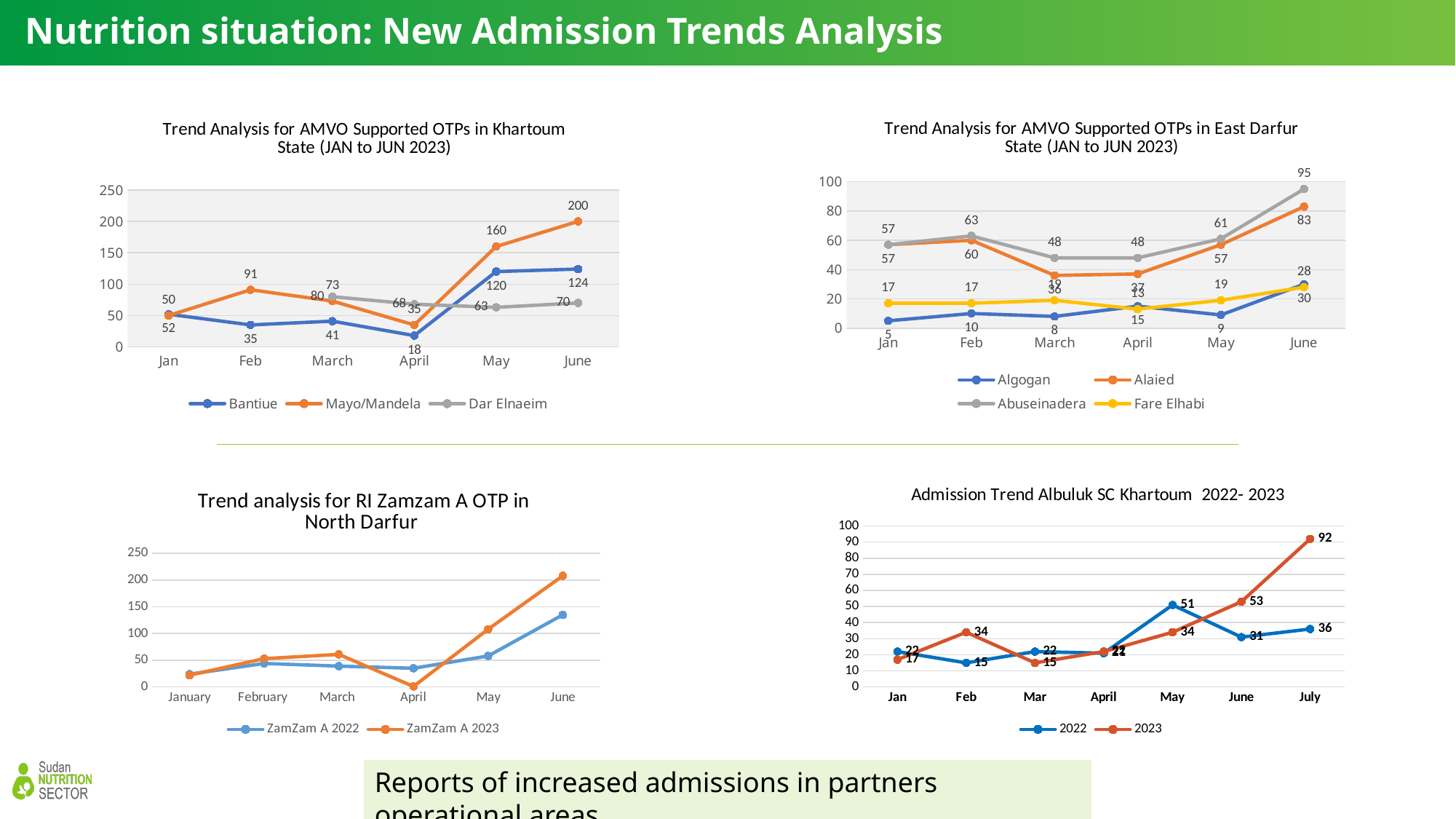
In the Khartoum State chart (top left), what is the value for Mayo/Mandela in June? 200 In the Khartoum State chart (top left), what is the difference between Mayo/Mandela and Bantiue in June? 76 In the Khartoum State chart (top left), how many series does the legend list? 3 In the Albuluk SC Khartoum chart (bottom right), how many months are shown on the x axis? 7 In the East Darfur State chart (top right), what is the value for Fare Elhabi in April? 13 In the East Darfur State chart (top right), what is the value for Algogan in January? 5 In the Albuluk SC Khartoum chart (bottom right), what is the value for 2023 in July? 92 In the Khartoum State chart (top left), what is the value for Bantiue in April? 18 What kind of chart is the RI Zamzam A OTP chart (bottom left)? line chart In the RI Zamzam A OTP chart (bottom left), is the value for ZamZam A 2023 in June greater or less than 150? greater In the East Darfur State chart (top right), which is larger in March: Alaied or Abuseinadera? Abuseinadera In the East Darfur State chart (top right), which series has the highest value in June? Abuseinadera